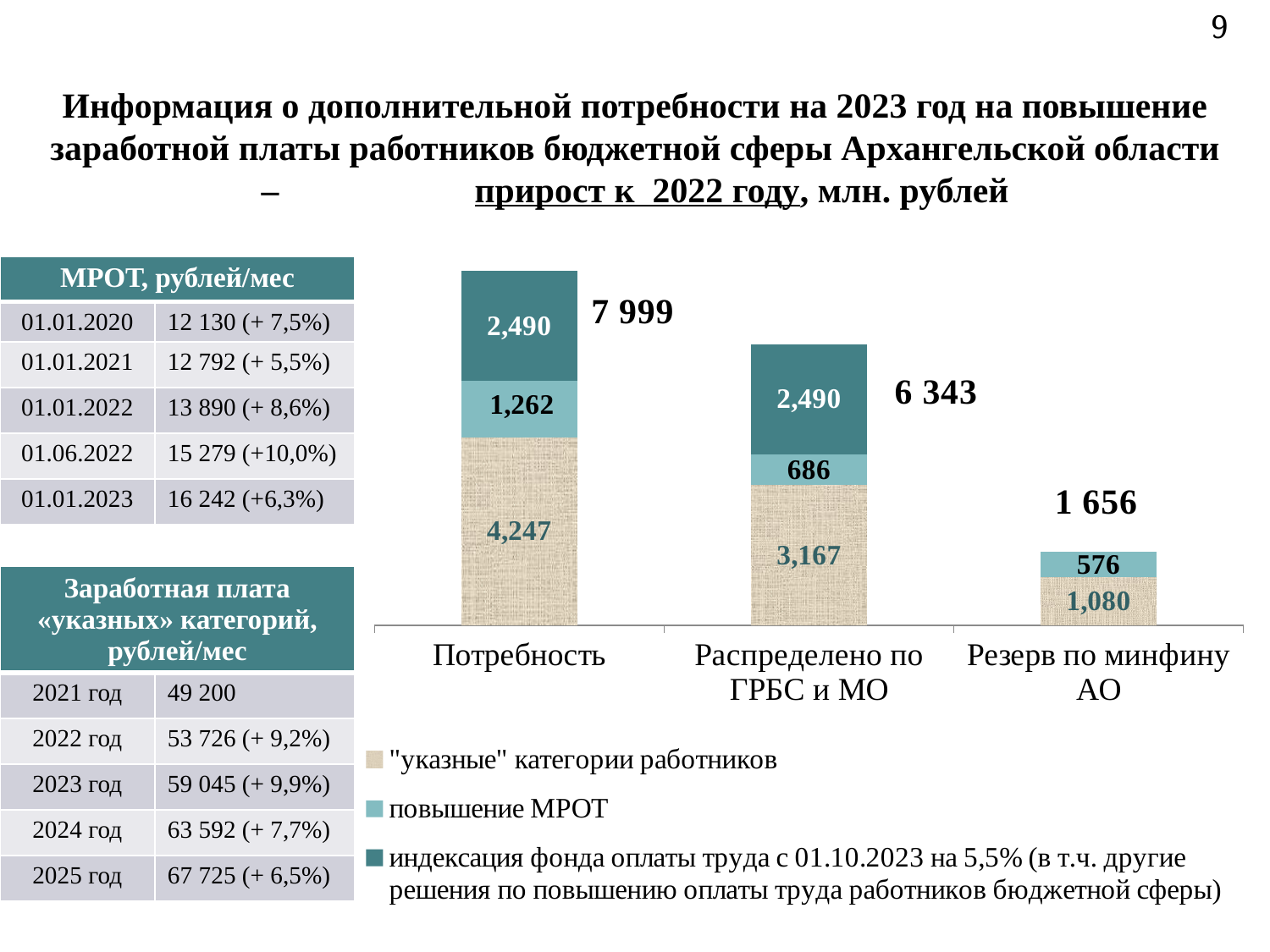
What is the value of the "указные" категории работников segment for Потребность? 4,247 What is the total shown above the Резерв по минфину АО bar? 1 656 How many series does the chart legend list? 3 What kind of chart is shown on the slide? stacked bar chart Which is larger: the "указные" категории работников value for Потребность or for Распределено по ГРБС и МО? Потребность What is the difference between the повышение МРОТ values for Потребность and Распределено по ГРБС и МО? 576 Which category has the lowest total? Резерв по минфину АО What is the total shown above the Потребность bar? 7 999 What is the value of the повышение МРОТ segment for Распределено по ГРБС и МО? 686 Which category has the highest total? Потребность What is the value of the "указные" категории работников segment for Резерв по минфину АО? 1,080 How many categories are shown on the x axis of the chart? 3